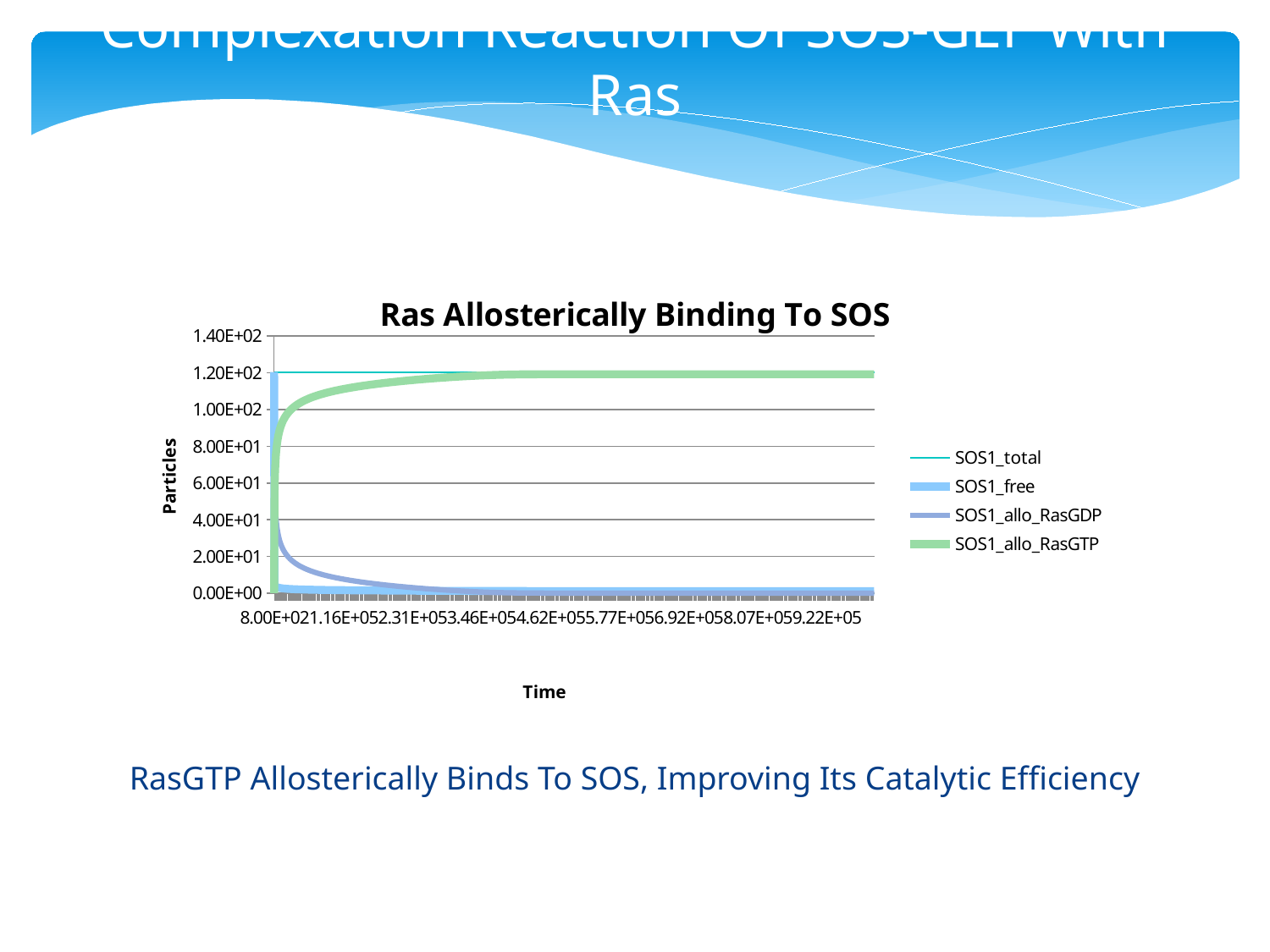
At the right end of the chart, is the value of SOS1_allo_RasGDP greater or less than 2.00E+01? less Does the SOS1_allo_RasGDP series rise or fall over time? fall What is the title of the chart? Ras Allosterically Binding To SOS At the right end of the chart, is the value of SOS1_allo_RasGTP greater or less than 1.00E+02? greater What is the label of the vertical axis of the chart? Particles At the right end of the chart, which series has the larger value: SOS1_allo_RasGTP or SOS1_allo_RasGDP? SOS1_allo_RasGTP How many series does the legend of the chart list? 4 What kind of chart is shown on the slide? line chart At the right end of the chart, which series has the larger value: SOS1_total or SOS1_free? SOS1_total Does the SOS1_allo_RasGTP series rise or fall over time? rise